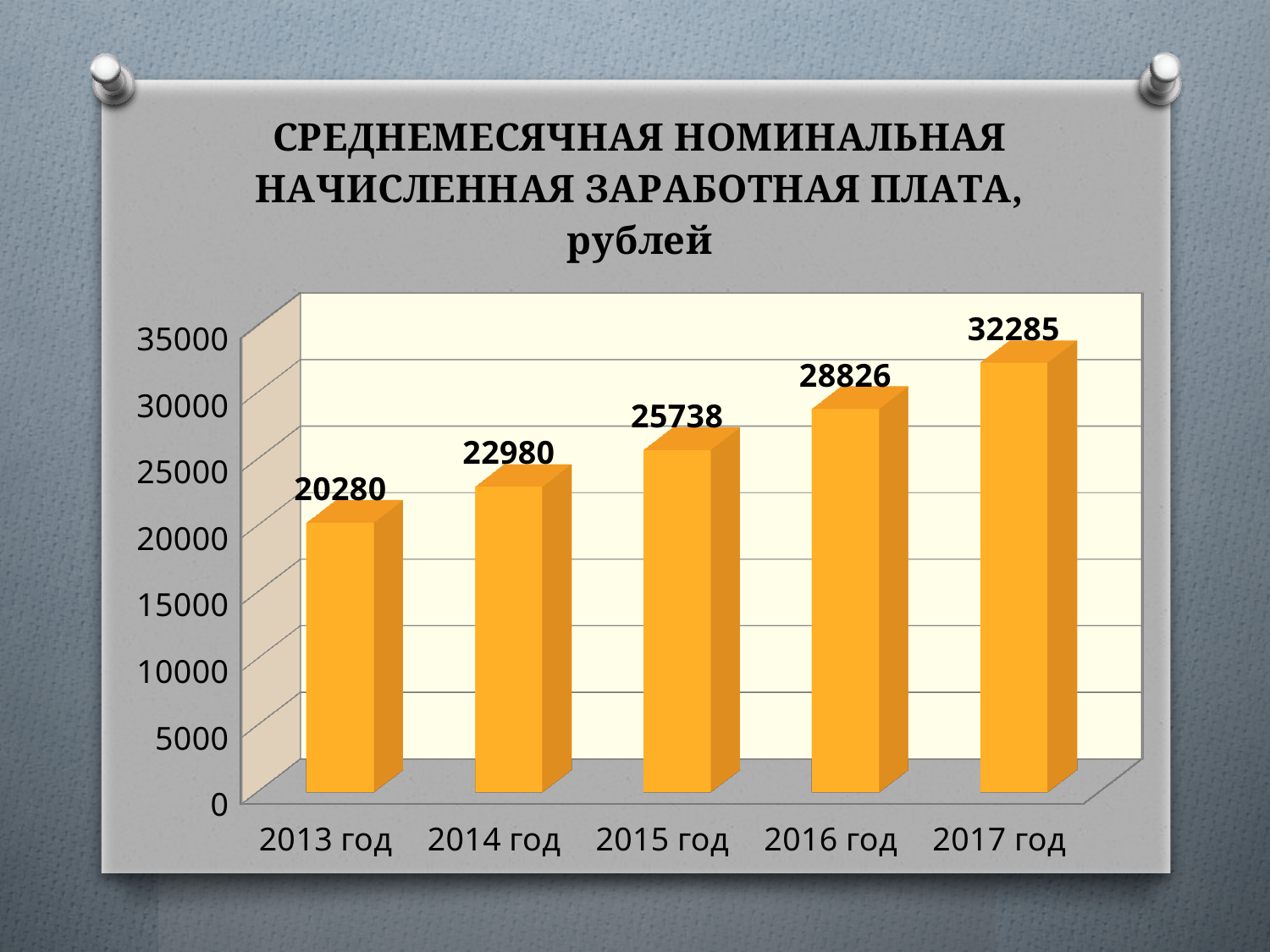
Is the value for 2016 год greater or less than 25000? greater Do the values rise or fall from 2013 год to 2017 год? rise What is the difference between the values for 2017 год and 2016 год? 3459 How many years are shown on the chart? 5 Which is larger, the value for 2014 год or the value for 2016 год? 2016 год Which year has the highest value? 2017 год What kind of chart is shown on the slide? bar chart What is the value for 2015 год? 25738 What is the value for 2017 год? 32285 Which year has the lowest value? 2013 год What is the difference between the values for 2014 год and 2013 год? 2700 What is the value for 2013 год? 20280